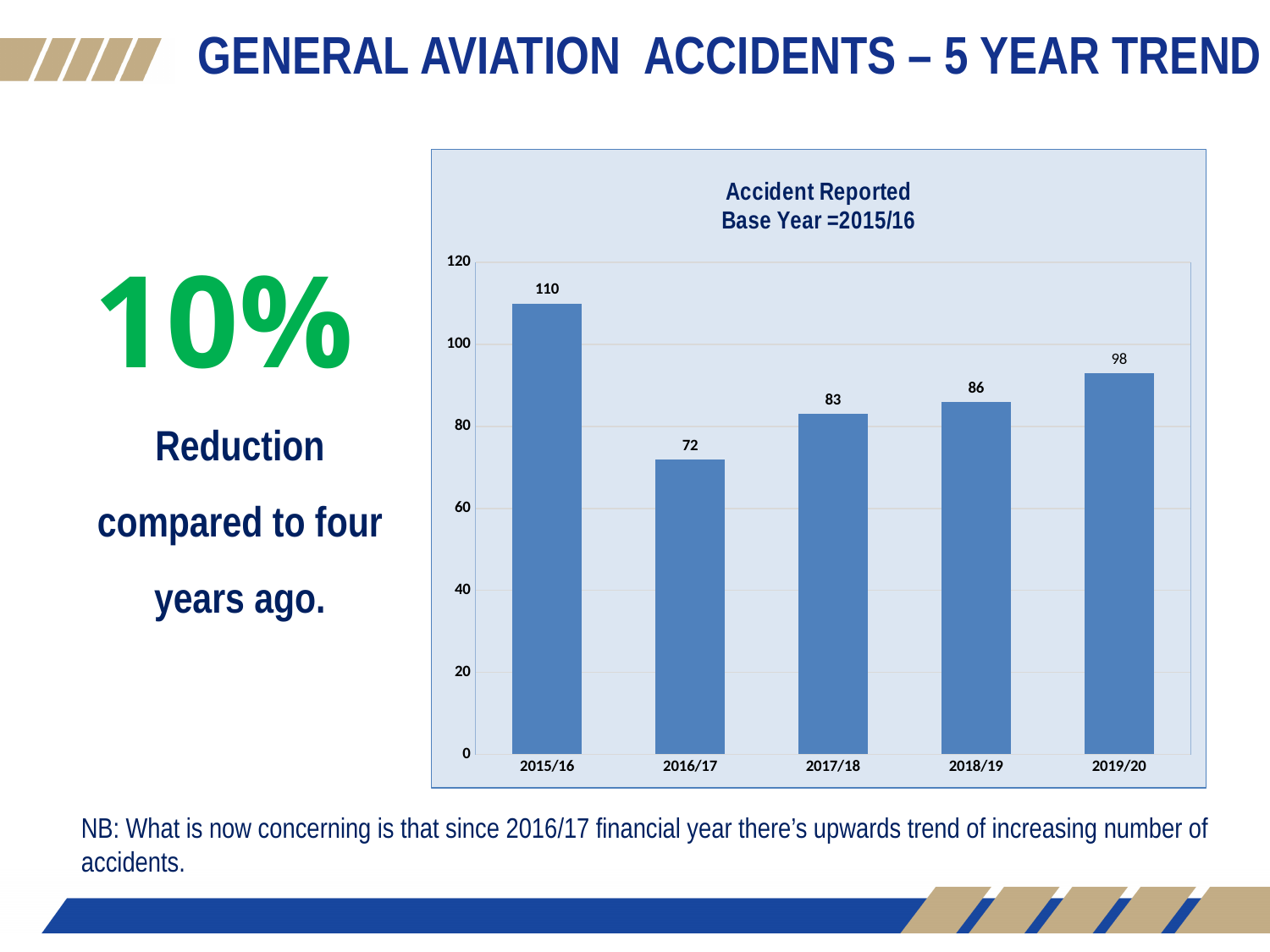
Do the values rise or fall from 2016/17 to 2019/20? rise What is the difference between the values for 2018/19 and 2017/18? 3 Which year has the lowest number of accidents reported? 2016/17 How many accidents were reported in 2015/16? 110 How many years are shown on the x axis? 5 What is the difference between the values for 2015/16 and 2019/20? 12 Is the value for 2016/17 greater or less than 80? less What kind of chart is shown on the slide? bar chart What is the value for 2016/17? 72 Which is larger, the value for 2017/18 or the value for 2019/20? 2019/20 Which year has the highest number of accidents reported? 2015/16 What is the value for 2019/20? 98